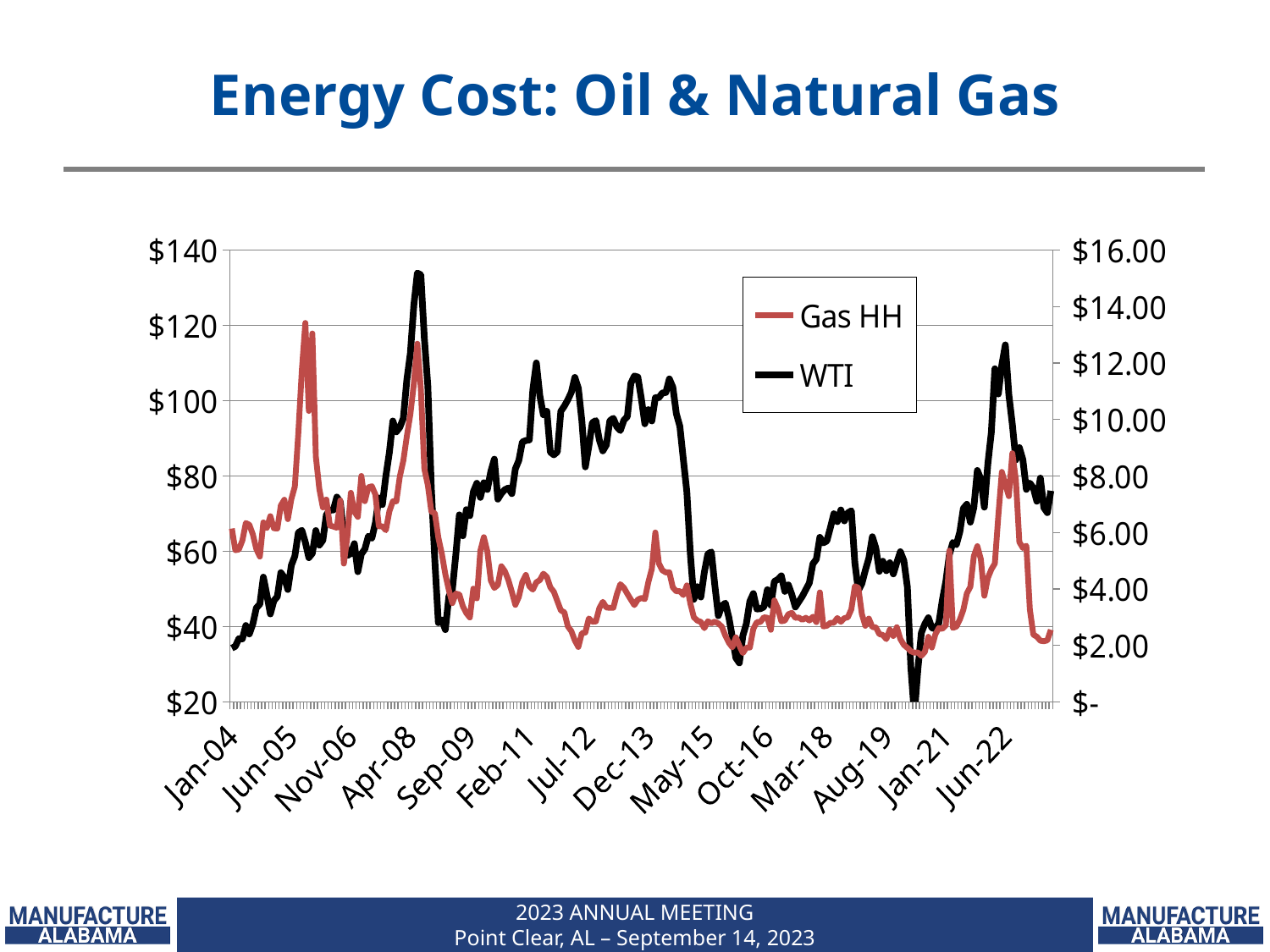
Is the peak value of the WTI series (around Apr-08) greater or less than $120 on the left axis? greater Does the Gas HH series rise or fall from its peak near Jun-22 to the end of the chart? fall What kind of chart is shown on the slide? line chart Is the WTI value at Jan-04 greater or less than $40 on the left axis? less How many date labels are shown along the x axis? 14 Does the WTI series generally rise or fall between Jan-04 and Apr-08? rise What are the two series named in the legend? Gas HH and WTI Is the lowest value of the WTI series greater or less than $40 on the left axis? less How many series does the legend list? 2 What is the title of the slide containing the chart? Energy Cost: Oil & Natural Gas